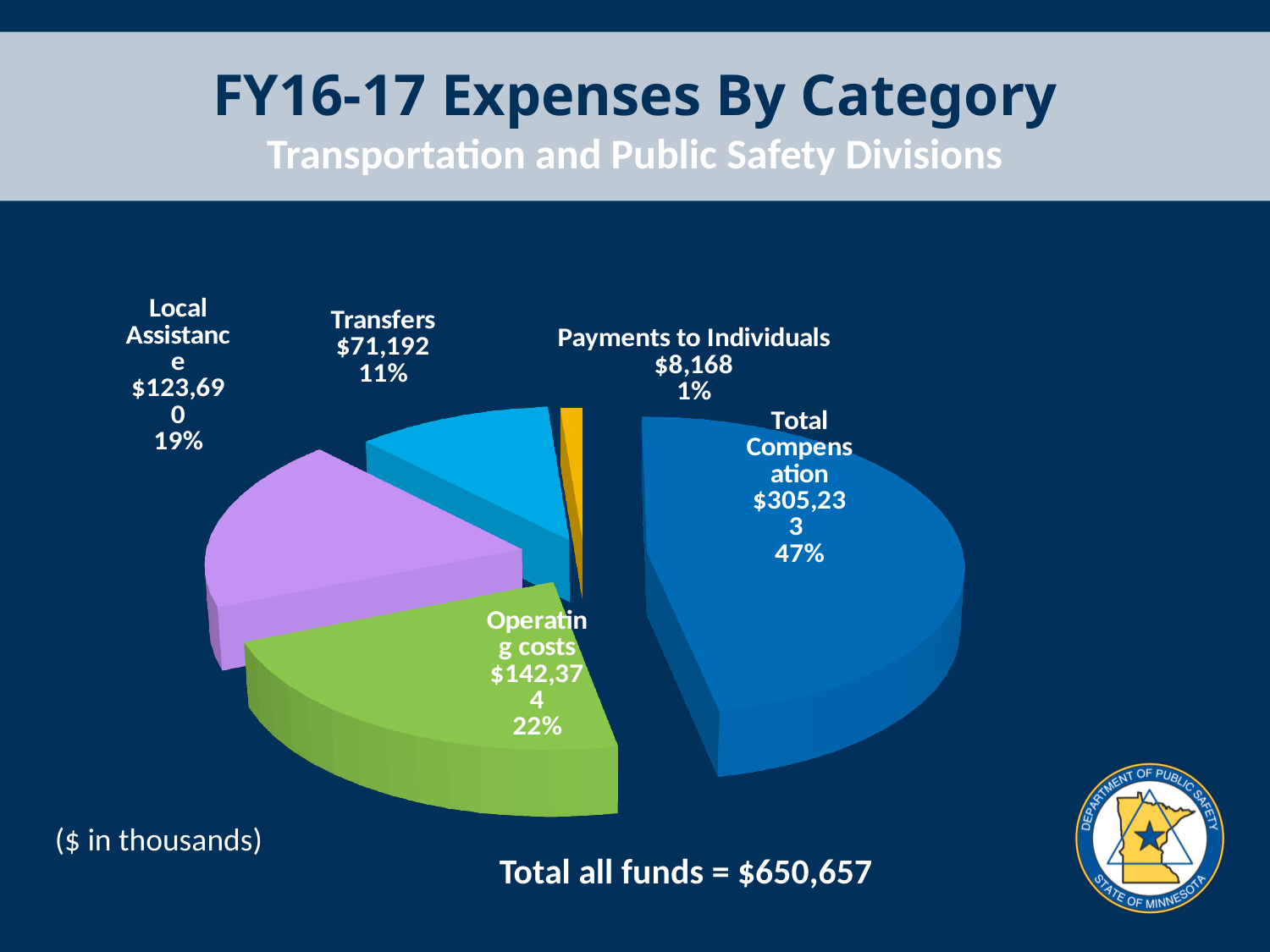
What is the difference between Operating costs and Local Assistance? $18,684 What share of the pie does Local Assistance represent? 19% What kind of chart is shown on the slide? Pie chart What is the total of all funds shown on the slide? $650,657 What is the value for Operating costs? $142,374 What share of the pie does Payments to Individuals represent? 1% Which is larger, Transfers or Local Assistance? Local Assistance How many categories does the pie chart show? 5 What is the value for Total Compensation? $305,233 Which category has the smallest expense? Payments to Individuals What is the value for Transfers? $71,192 Which category has the largest expense? Total Compensation